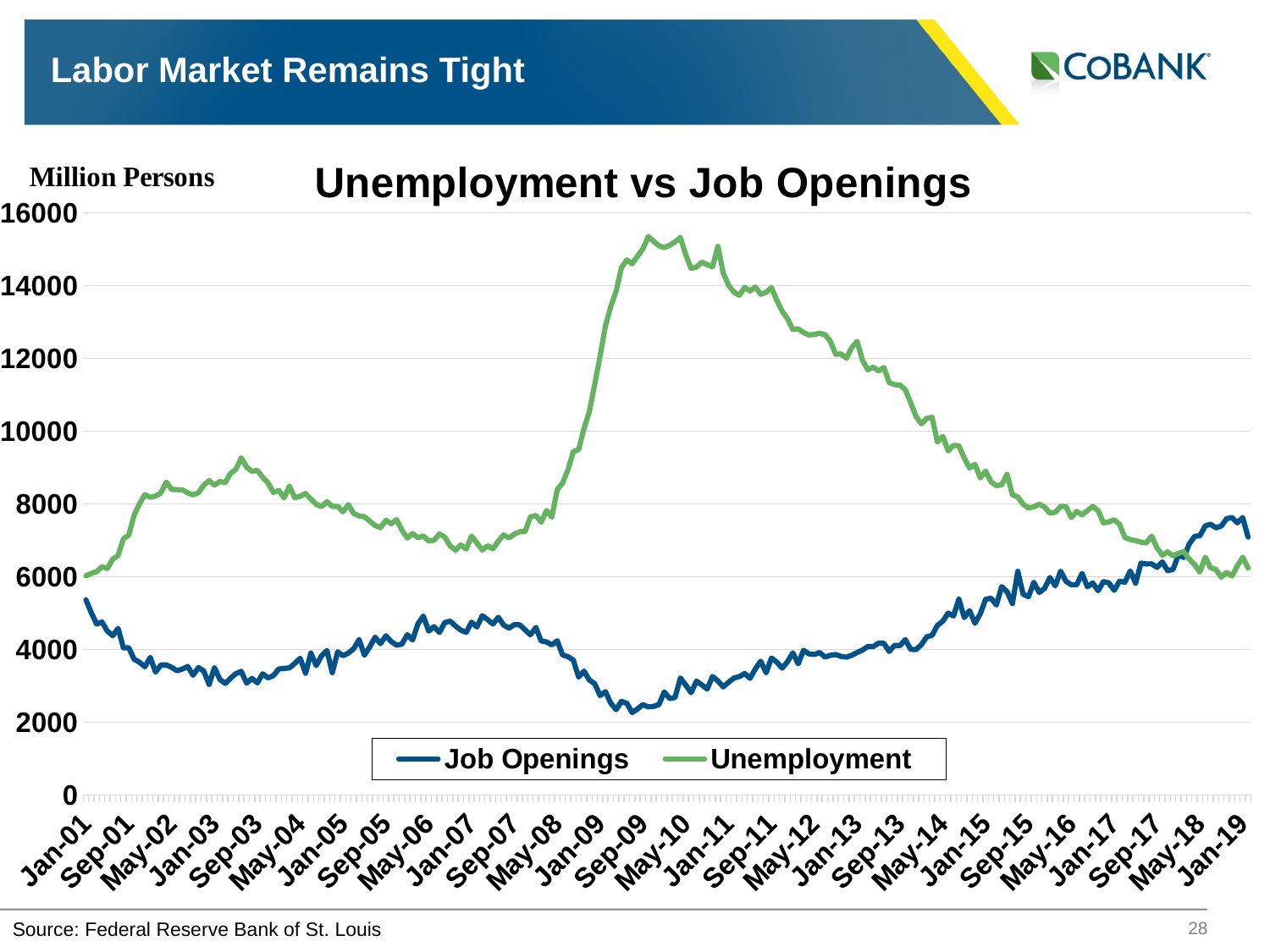
Which series is drawn in green? Unemployment What is the title of the chart? Unemployment vs Job Openings What kind of chart is shown on the slide? line chart How many series does the legend list? 2 Is the peak value of the Unemployment series greater or less than 14000? greater At Sep-09, which series has the larger value, Job Openings or Unemployment? Unemployment Is the value of Job Openings around Sep-09 greater or less than 4000? less Is the value of Unemployment at Jan-19 greater or less than 8000? less Does the Unemployment series rise or fall between Sep-09 and Jan-19? fall Which series reaches the highest value on the chart? Unemployment Which series reaches the lowest value on the chart? Job Openings